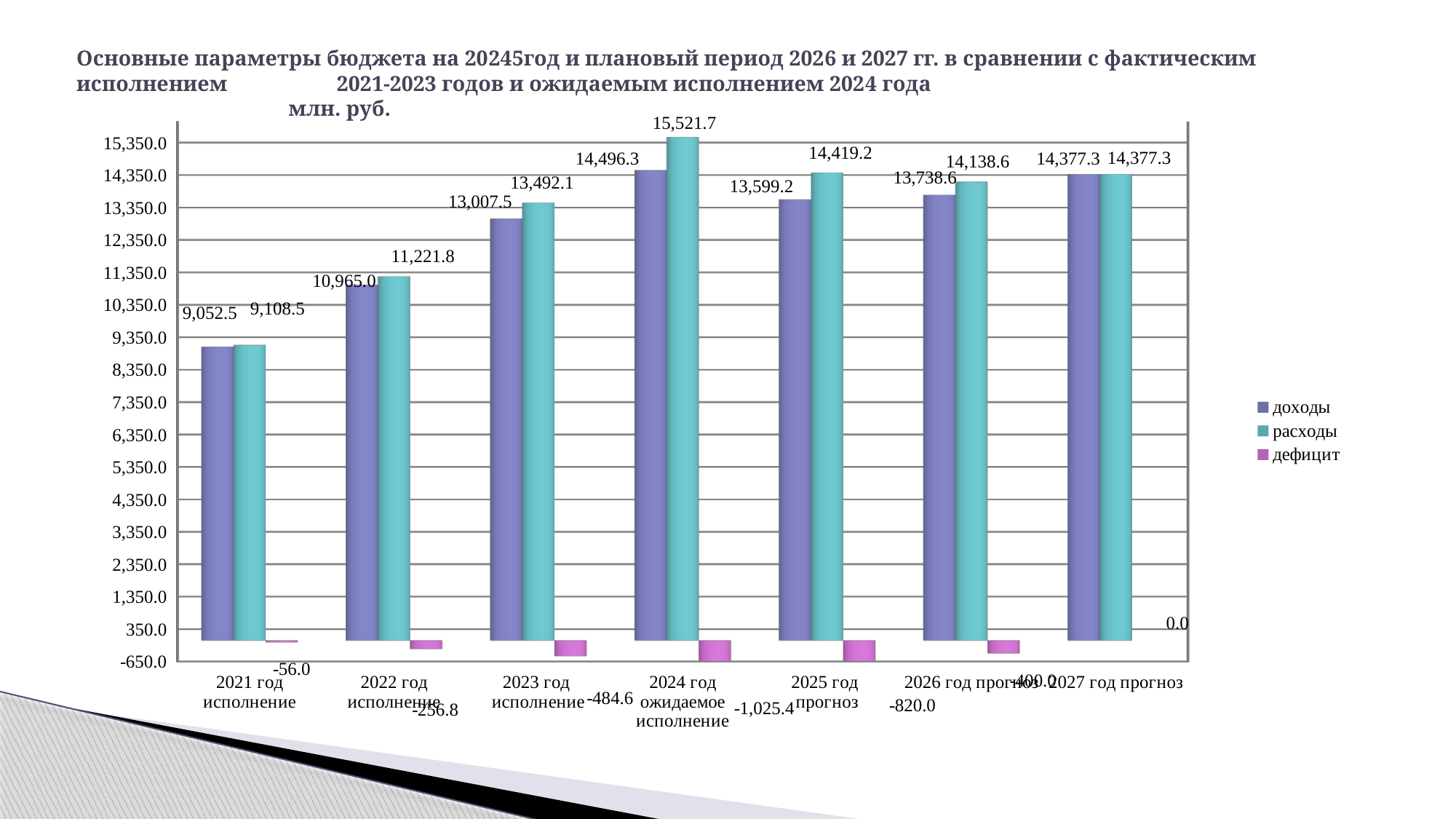
What is the value of расходы for 2027 год прогноз? 14,377.3 How many series does the legend list? 3 Is the value of доходы for 2025 год прогноз greater or less than 14,350.0? less What is the value of доходы for 2021 год исполнение? 9,052.5 How many categories are shown on the x axis? 7 Which is larger for 2022 год исполнение: доходы or расходы? расходы What kind of chart is shown on the slide? bar chart What is the value of расходы for 2024 год ожидаемое исполнение? 15,521.7 Which category has the highest value of расходы? 2024 год ожидаемое исполнение Which category has the lowest value of доходы? 2021 год исполнение What is the difference between расходы and доходы for 2023 год исполнение? 484.6 What is the value of дефицит for 2025 год прогноз? -820.0